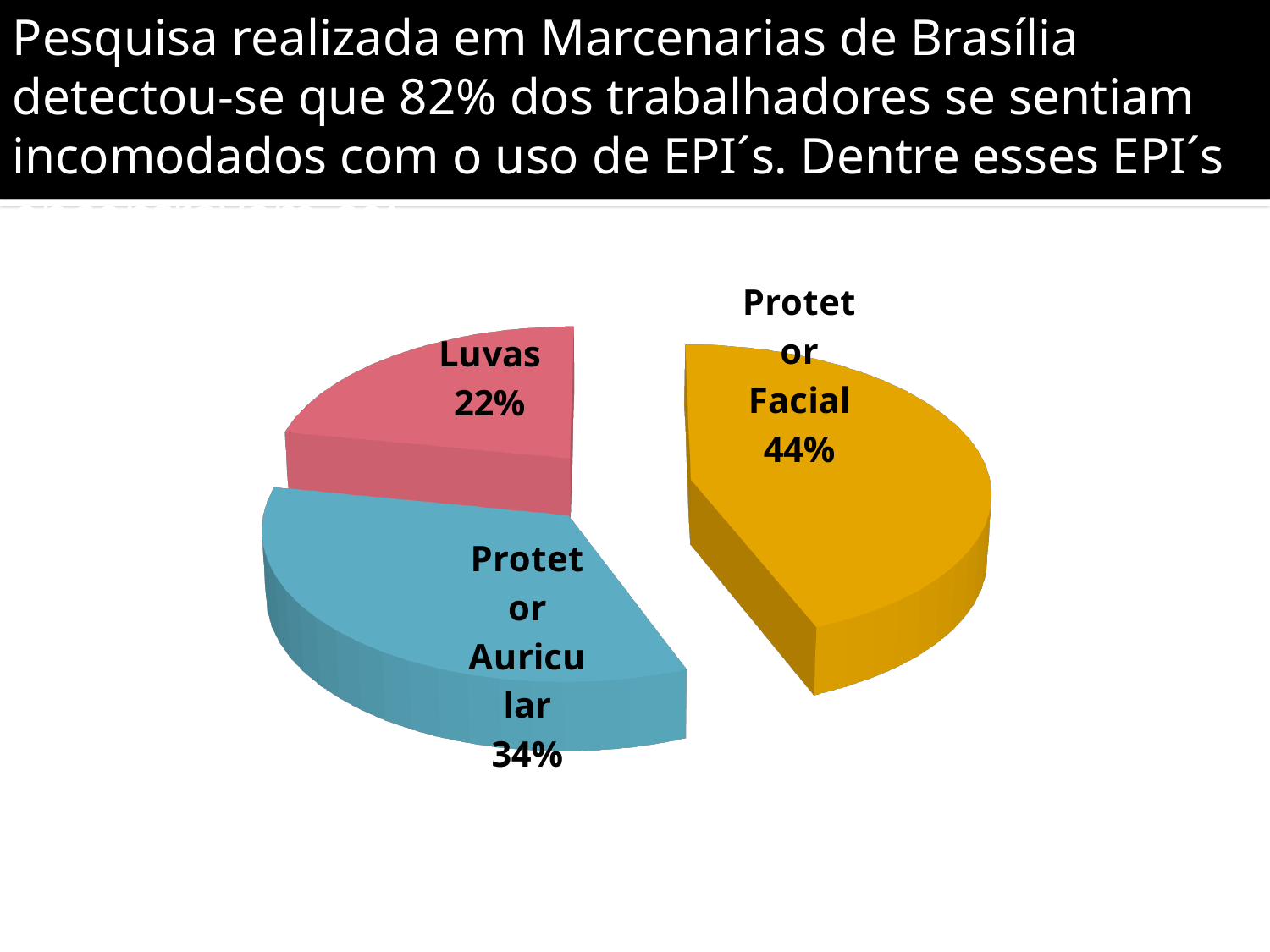
What is the difference in percentage points between the Protetor Facial slice and the Luvas slice? 22 What colour is the Luvas slice of the pie chart? Pink What percentage of the pie chart is labelled Protetor Auricular? 34% What percentage of the pie chart is labelled Luvas? 22% What colour is the Protetor Facial slice of the pie chart? Yellow What percentage of the pie chart is labelled Protetor Facial? 44% What kind of chart is shown on the slide? Pie chart Which is larger, the Protetor Auricular slice or the Luvas slice? Protetor Auricular What is the difference in percentage points between the Protetor Facial slice and the Protetor Auricular slice? 10 Which slice of the pie chart is the largest? Protetor Facial How many slices does the pie chart have? 3 Which slice of the pie chart is the smallest? Luvas